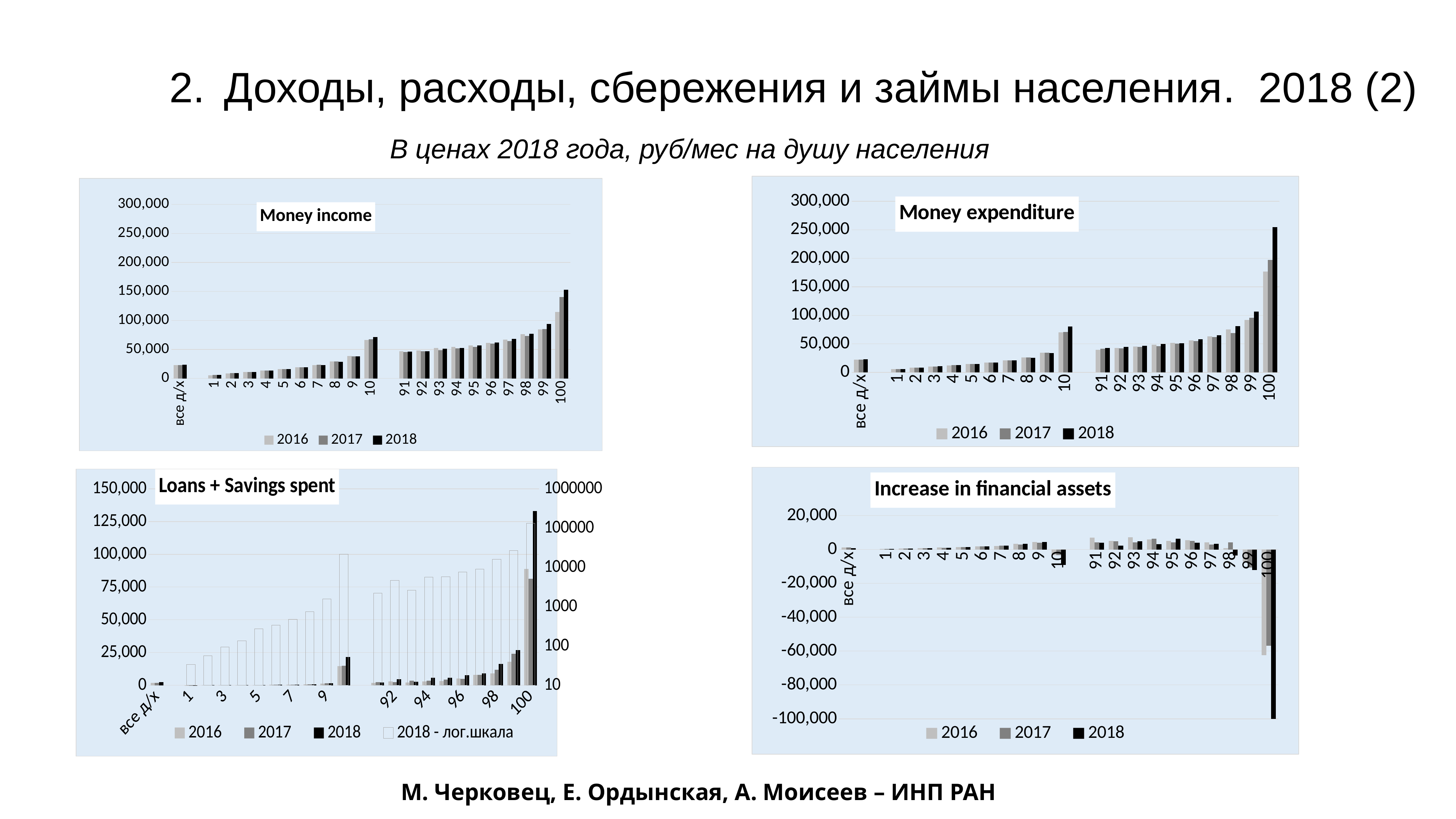
How many series does the legend of the "Money income" chart list? 3 In the "Money income" chart, is the 2018 value for category 10 greater or less than 100,000? less In the "Money income" chart, do the values rise or fall from category 91 to category 100? rise In the "Money expenditure" chart, is the 2018 value for category 100 greater or less than 200,000? greater In the "Increase in financial assets" chart, which category has the lowest value? 100 In the "Money income" chart, is the 2018 value for category 100 greater or less than 100,000? greater In the "Money income" chart, which category has the highest value? 100 In the "Money expenditure" chart, which is larger for category 100: the 2016 value or the 2018 value? 2018 What kind of chart is the "Money income" chart? bar chart How many series does the legend of the "Loans + Savings spent" chart list? 4